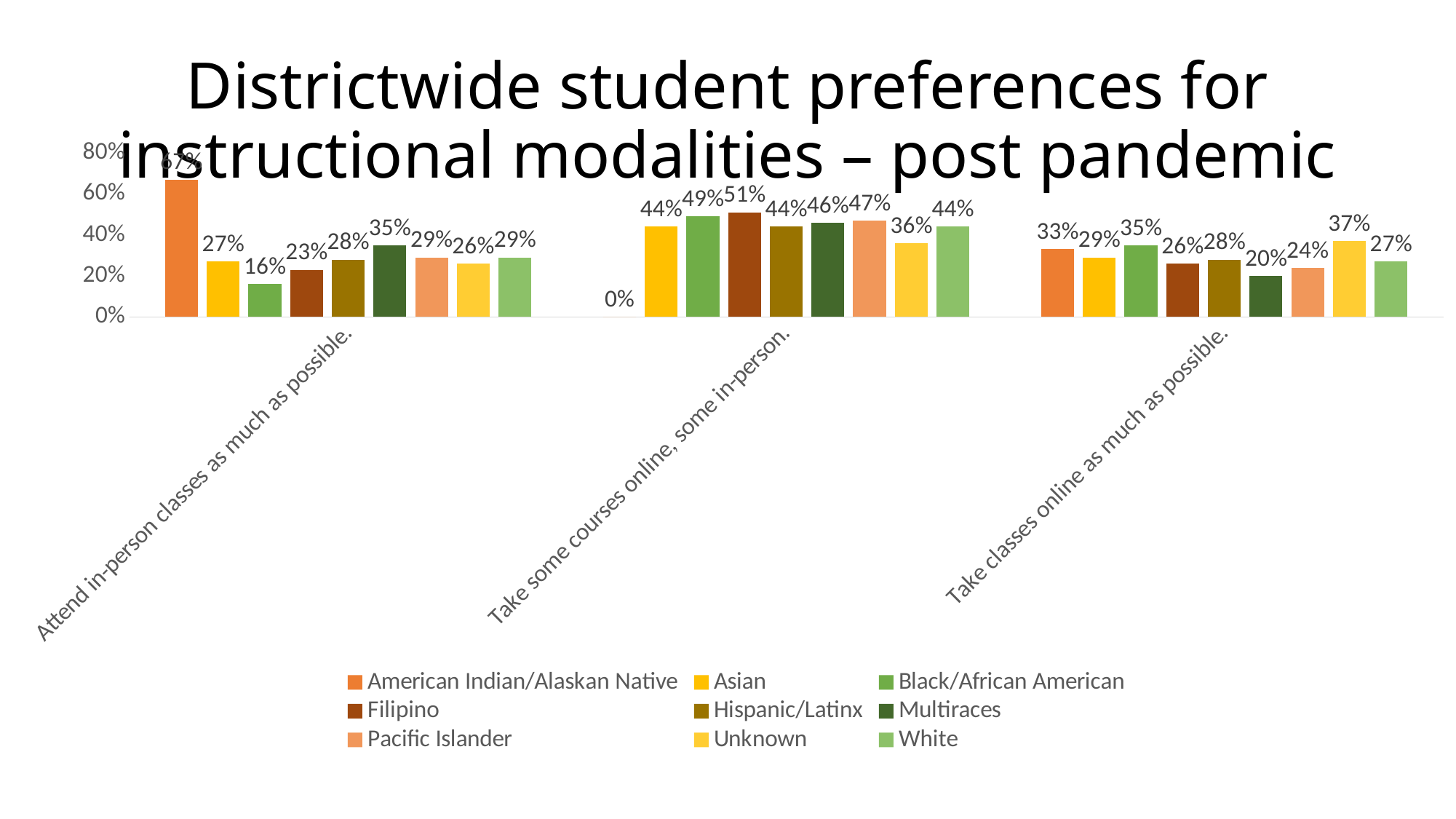
Is the value for American Indian/Alaskan Native students under 'Attend in-person classes as much as possible.' greater or less than 60%? greater What percentage of Asian students prefer to attend in-person classes as much as possible? 27% For 'Attend in-person classes as much as possible.', what is the difference between the Multiraces value and the Black/African American value? 19 percentage points Which group has the lowest value for 'Attend in-person classes as much as possible.'? Black/African American What is the value for American Indian/Alaskan Native students under 'Take some courses online, some in-person.'? 0% What percentage of students in the Unknown group prefer to take classes online as much as possible? 37% Which group has the lowest value for 'Take classes online as much as possible.'? Multiraces What is the value for Filipino students under 'Take some courses online, some in-person.'? 51% How many instructional modality categories are shown on the x axis? 3 Which group has the highest value for 'Take some courses online, some in-person.'? Filipino For 'Take some courses online, some in-person.', which is larger: the Pacific Islander value or the Unknown value? Pacific Islander How many series does the legend list? 9